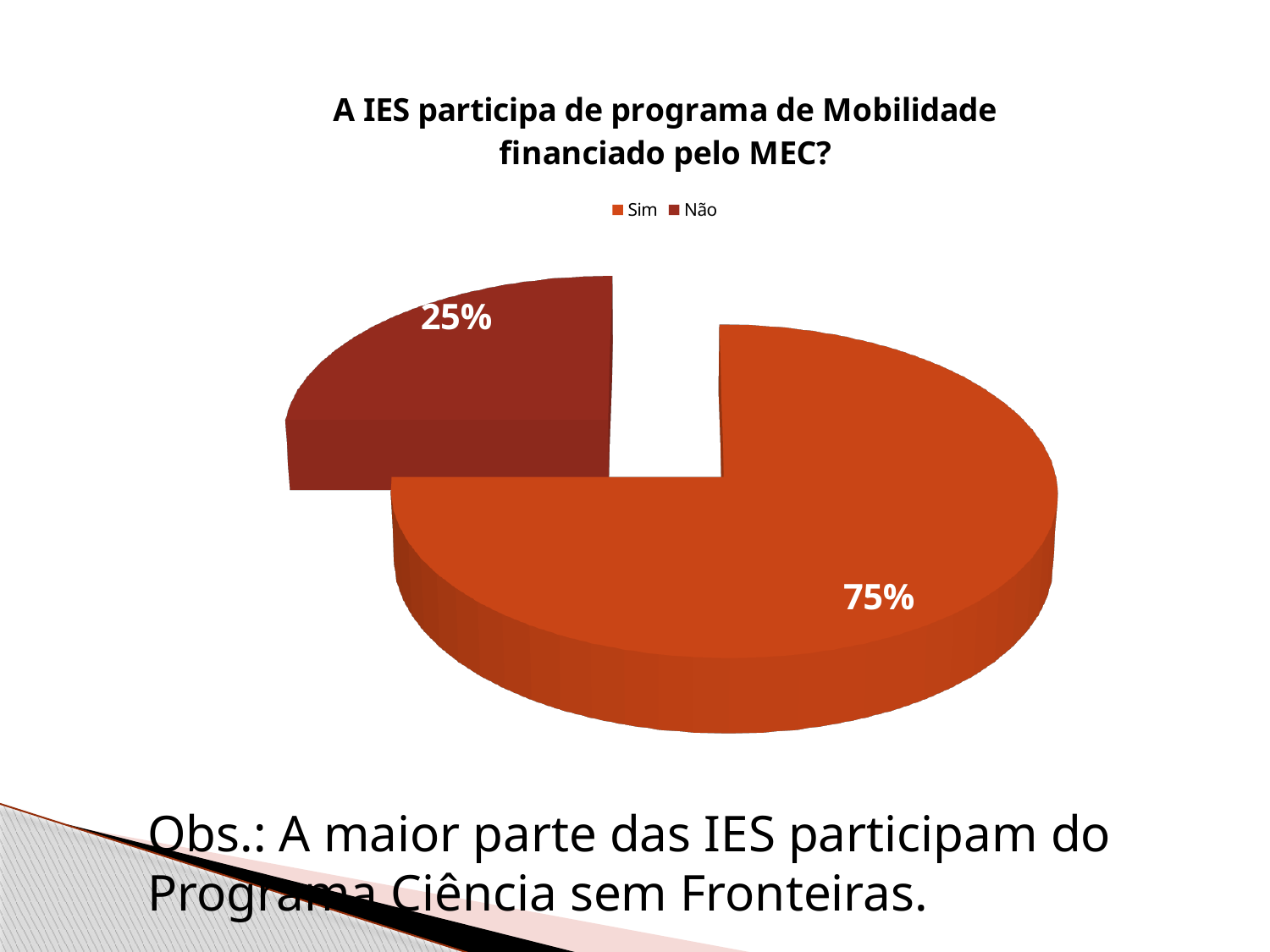
What is the title of the chart? A IES participa de programa de Mobilidade financiado pelo MEC? What percentage of the pie chart corresponds to "Não"? 25% How many entries does the legend list? 2 Which slice is larger, "Sim" or "Não"? Sim Which category has the largest share of the pie chart? Sim Which legend entry is shown in the darker red colour? Não What is the difference in percentage points between the "Sim" and "Não" slices? 50 Which category has the smallest share of the pie chart? Não What percentage of the pie chart corresponds to "Sim"? 75% How many slices does the pie chart have? 2 What kind of chart is shown on the slide? Pie chart What share of the pie does the "Sim" slice represent? 75%